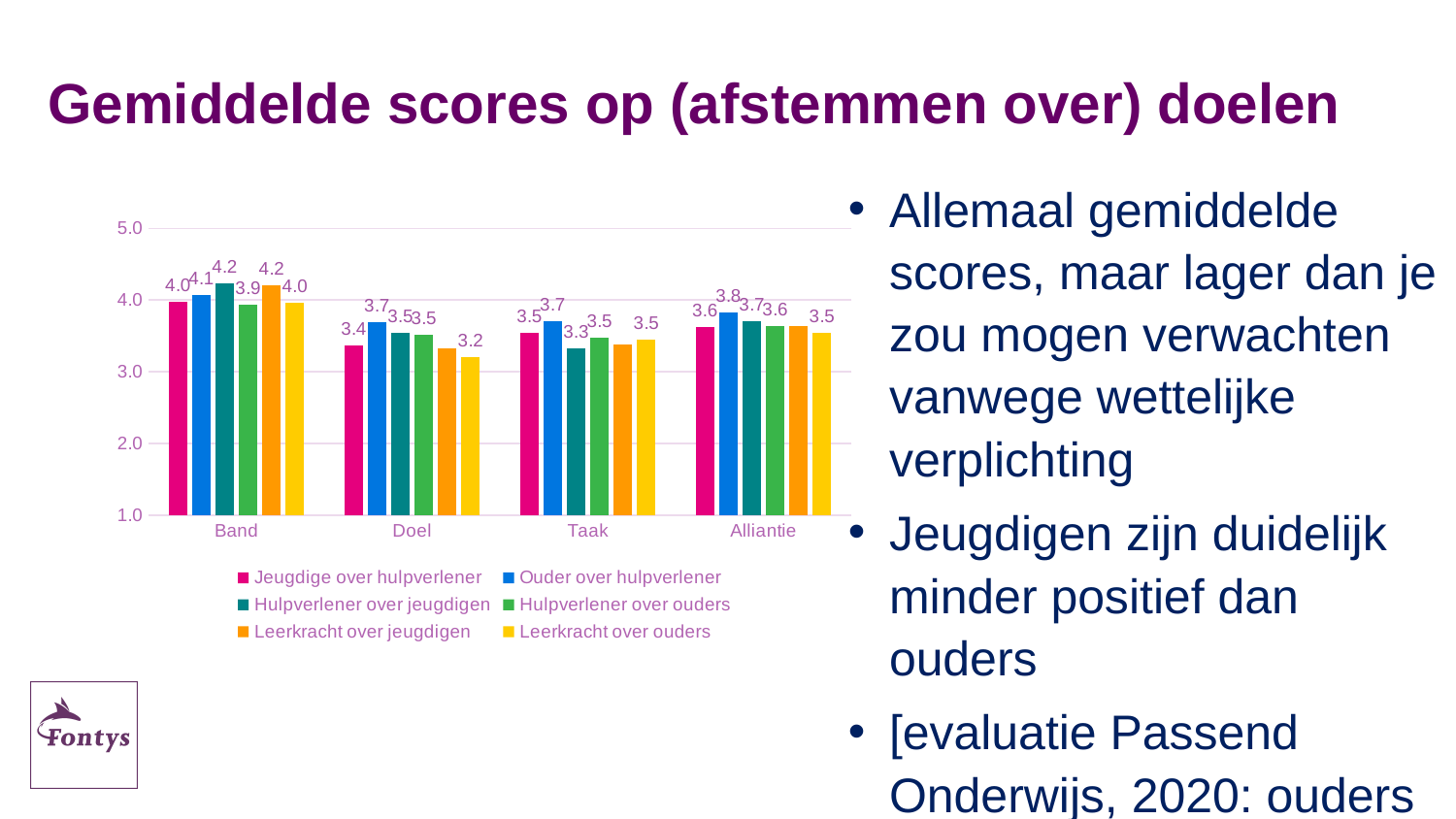
What is the value for 'Jeugdige over hulpverlener' in the Band category? 4.0 What is the difference between the 'Jeugdige over hulpverlener' values for Band and Doel? 0.6 What is the value for 'Ouder over hulpverlener' in the Alliantie category? 3.8 What is the title of the slide containing the chart? Gemiddelde scores op (afstemmen over) doelen What is the value for 'Leerkracht over ouders' in the Doel category? 3.2 For the series 'Jeugdige over hulpverlener', which category has the lowest value? Doel What kind of chart is shown on the slide? Bar chart In the Alliantie category, which is larger: 'Ouder over hulpverlener' or 'Jeugdige over hulpverlener'? Ouder over hulpverlener Is the value for 'Leerkracht over ouders' in the Doel category greater or less than 4.0? less For the series 'Ouder over hulpverlener', which category has the highest value? Band How many categories are shown on the x axis of the chart? 4 How many series does the chart legend list? 6